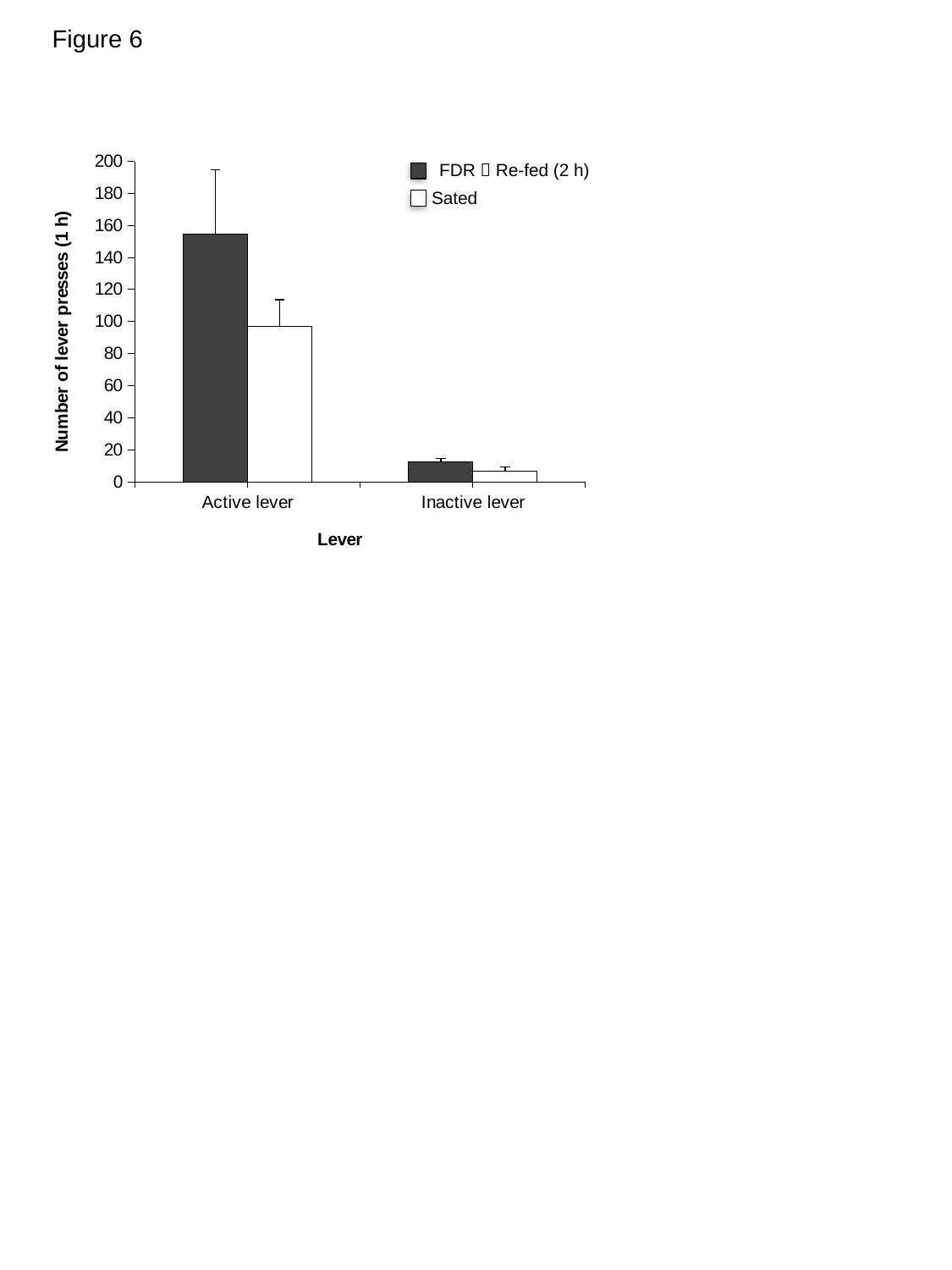
How many categories are shown on the x axis of the chart? 2 What is the label of the y axis of the chart? Number of lever presses (1 h) How many series does the chart's legend list? 2 Is the value for Sated on the Active lever greater or less than 120? less For the Active lever, which series has the larger value, FDR Re-fed (2 h) or Sated? FDR Re-fed (2 h) Is the value for FDR Re-fed (2 h) on the Inactive lever greater or less than 20? less Which category has the highest bar in the chart? Active lever What kind of chart is shown on the slide? bar chart Is the value for FDR Re-fed (2 h) on the Active lever greater or less than 140? greater What is the label of the x axis of the chart? Lever Which series has the lowest bar in the chart? Sated (Inactive lever) For the Inactive lever, which series has the larger value, FDR Re-fed (2 h) or Sated? FDR Re-fed (2 h)